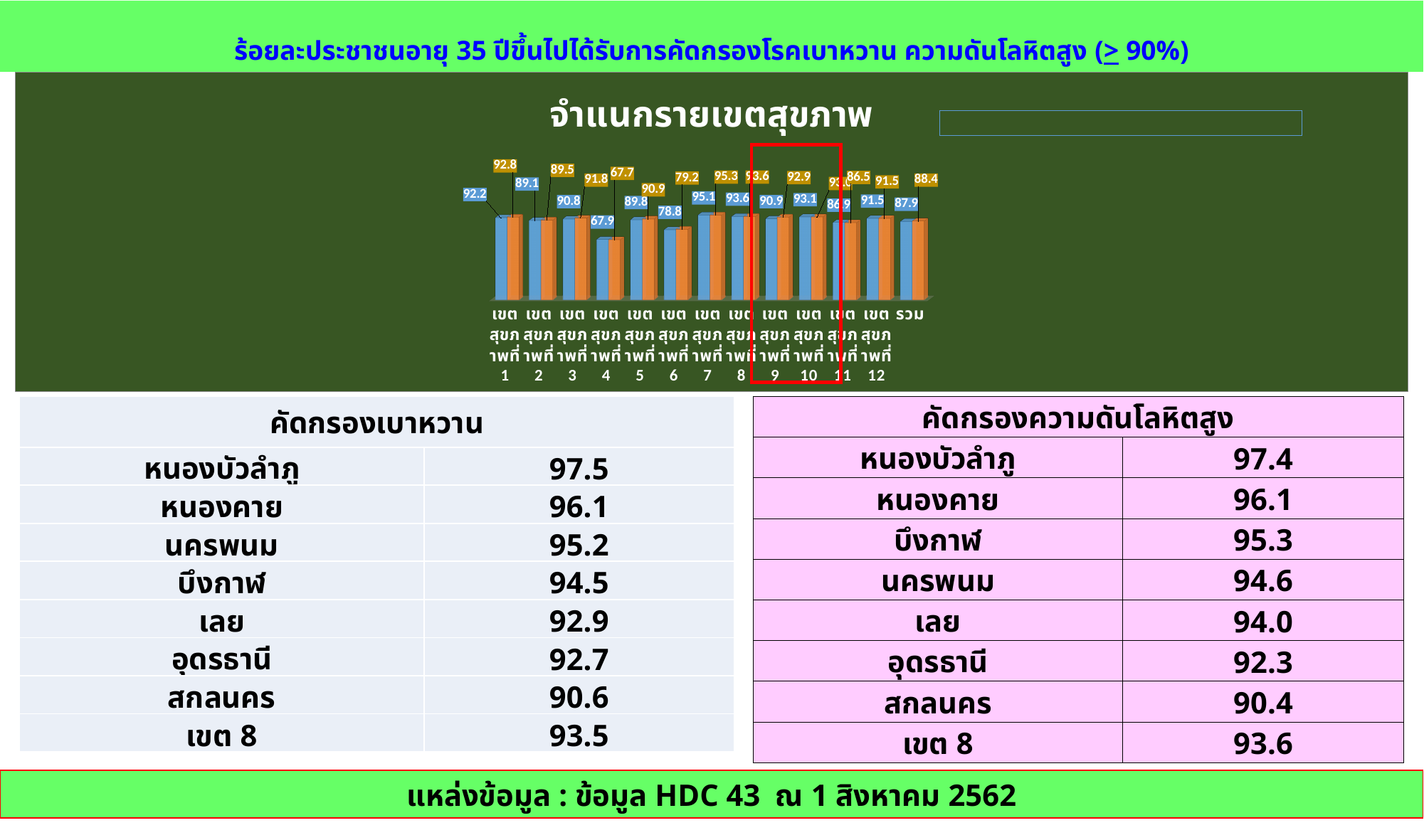
What is the value of the orange bar for เขตสุขภาพที่ 5? 90.9 Which has the larger blue bar, เขตสุขภาพที่ 2 or เขตสุขภาพที่ 6? เขตสุขภาพที่ 2 What kind of chart is shown on the slide? bar chart Which category has the lowest blue bar? เขตสุขภาพที่ 4 What is the difference between the blue bars for เขตสุขภาพที่ 7 and เขตสุขภาพที่ 4? 27.2 What is the value of the blue bar for รวม? 87.9 What is the title of the chart? จำแนกรายเขตสุขภาพ What is the value of the orange bar for รวม? 88.4 What is the value of the orange bar for เขตสุขภาพที่ 1? 92.8 How many categories are shown along the x axis of the chart? 13 What is the value of the blue bar for เขตสุขภาพที่ 4? 67.9 Which category has the highest blue bar? เขตสุขภาพที่ 7